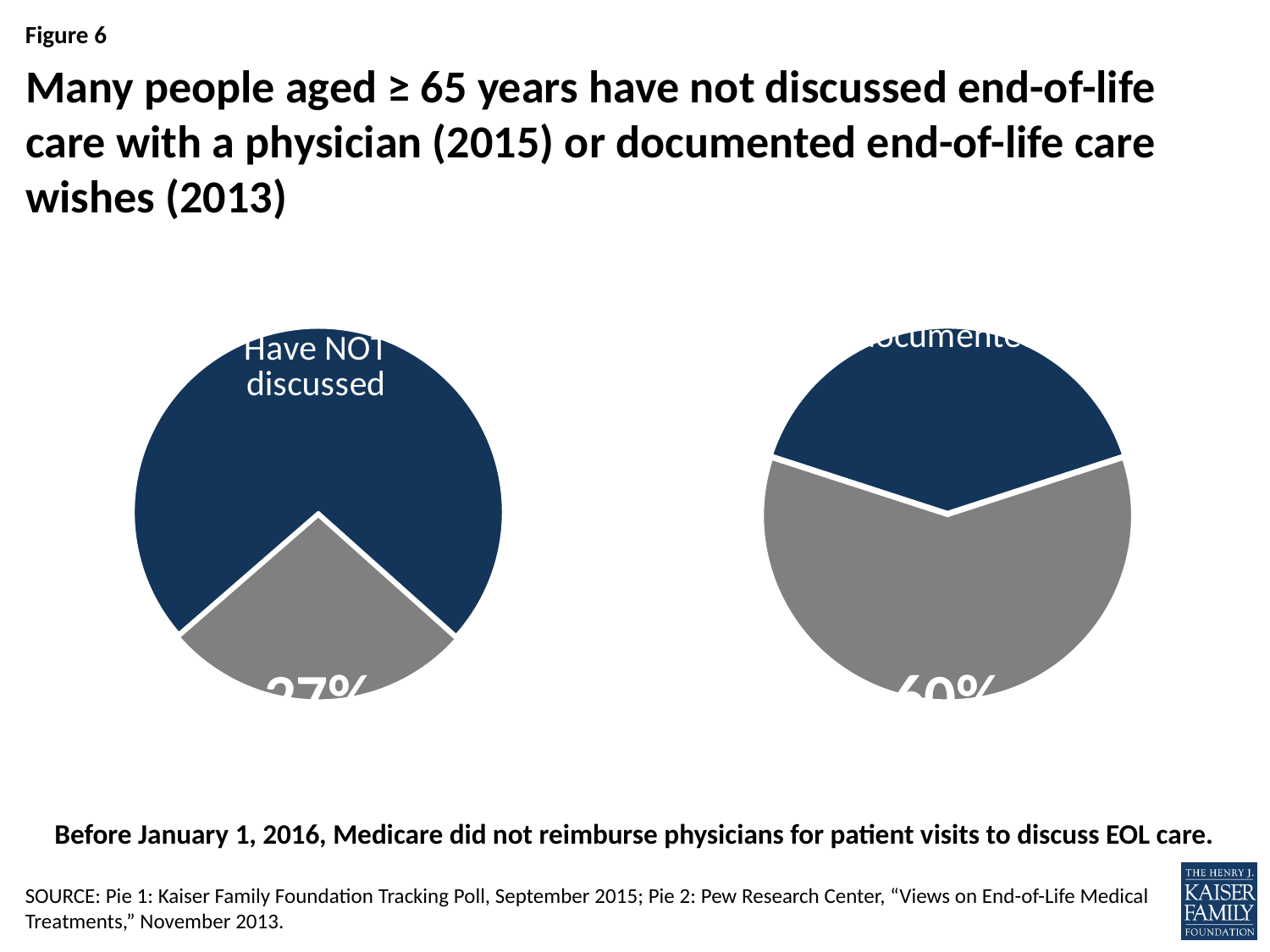
What kind of chart is the right chart on the slide? Pie chart How many charts are shown on the slide? 2 In the left pie chart, what colour is the 'Have NOT discussed' slice? Dark blue In the left pie chart, does the 'Have NOT discussed' slice make up more or less than half of the pie? More In the right pie chart, does the dark blue slice make up more or less than half of the pie? Less In the left pie chart, how many slices are there? 2 In the right pie chart, how many slices are there? 2 In the left pie chart, which slice is larger: the 'Have NOT discussed' slice or the grey slice? Have NOT discussed What kind of chart is the left chart on the slide? Pie chart What figure number is given for the charts on this slide? Figure 6